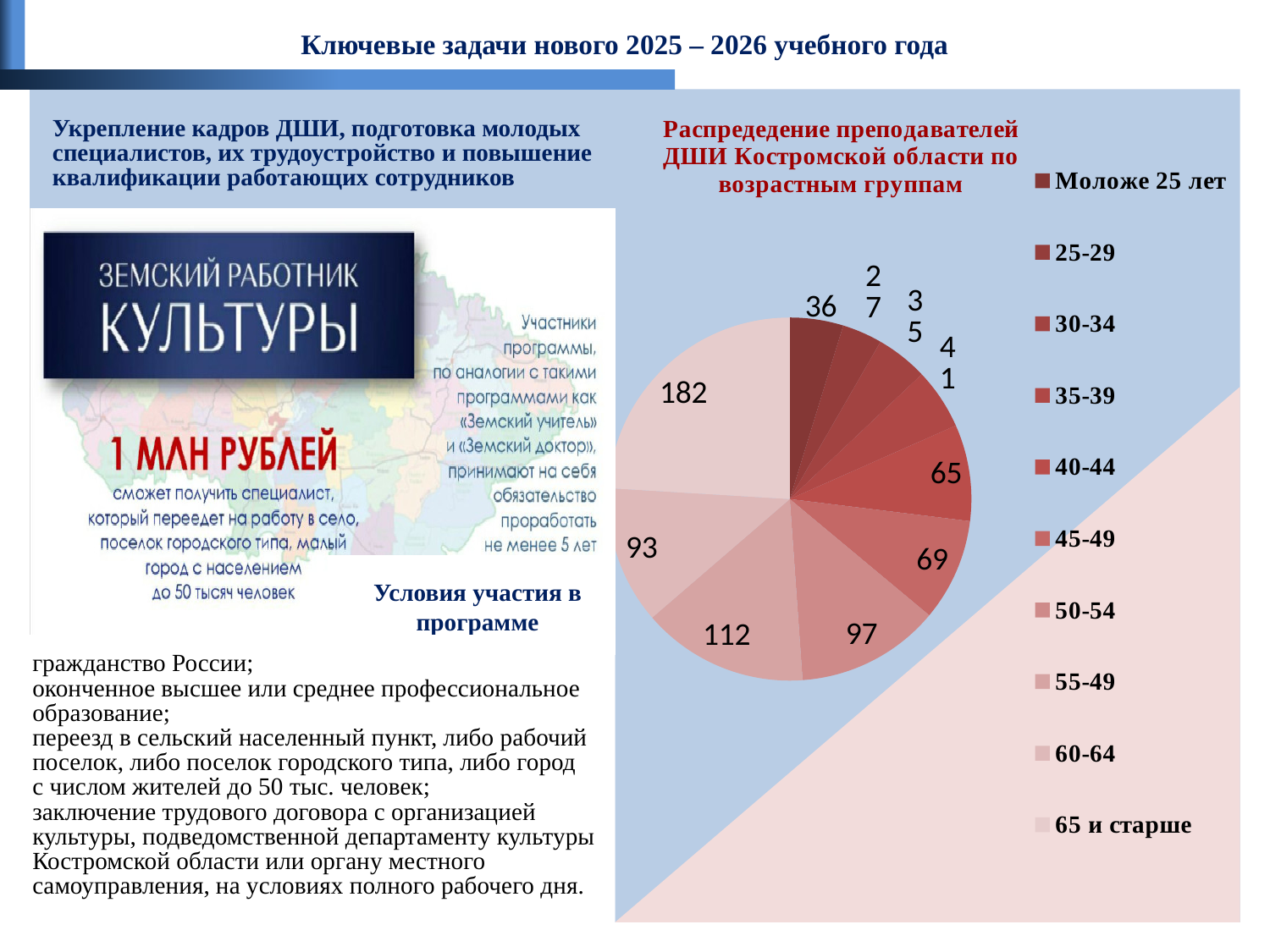
In the pie chart, what is the difference between the values for "50-54" and "45-49"? 28 In the pie chart, what is the value for the age group "40-44"? 65 In the pie chart, what is the value for the age group "65 и старше"? 182 Which age group has the smallest slice in the pie chart? 25-29 In the pie chart, which is larger: the value for "50-54" or the value for "60-64"? 50-54 In the pie chart, what is the difference between the values for "65 и старше" and "55-49"? 70 In the pie chart, what is the value for the age group "50-54"? 97 What kind of chart is shown on the right side of the slide? Pie chart In the pie chart, what is the value for the age group "Моложе 25 лет"? 36 What is the title of the pie chart? Распредедение преподавателей ДШИ Костромской области по возрастным группам Which age group has the largest slice in the pie chart? 65 и старше How many age groups does the pie chart's legend list? 10